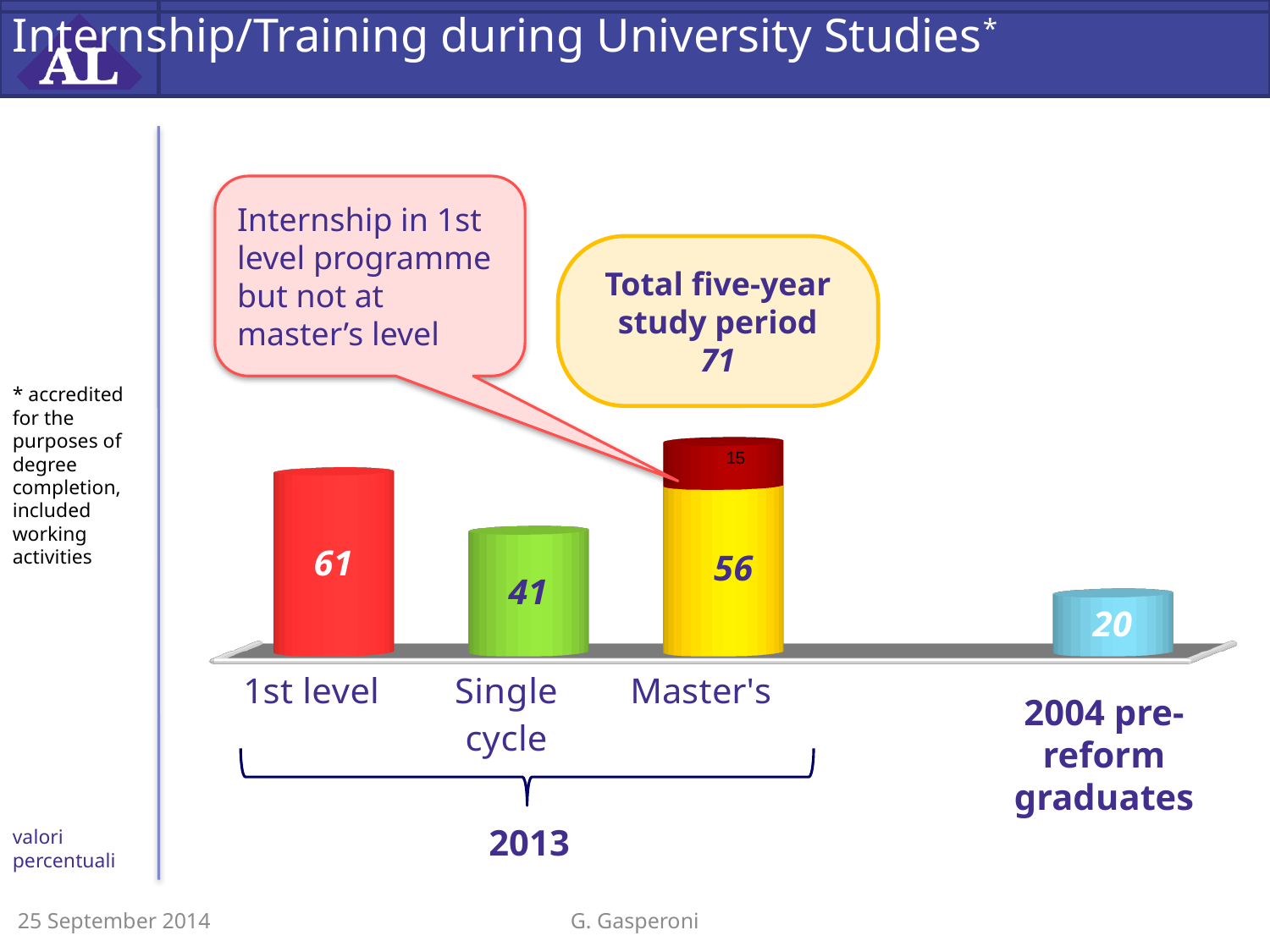
What is the value for 2004 pre-reform graduates? 20 Which is larger, the 1st level value or the yellow segment of the Master's bar? 1st level What is the value for Single cycle? 41 Which category has the lowest value? 2004 pre-reform graduates What is the value of the yellow segment of the Master's bar? 56 What is the value for 1st level? 61 What is the title of the slide? Internship/Training during University Studies* How many categories are shown on the x axis? 4 What kind of chart is shown on the slide? bar chart What is the value of the dark red segment on top of the Master's bar? 15 What is the total of the stacked Master's bar? 71 What is the difference between the 1st level value and the Single cycle value? 20